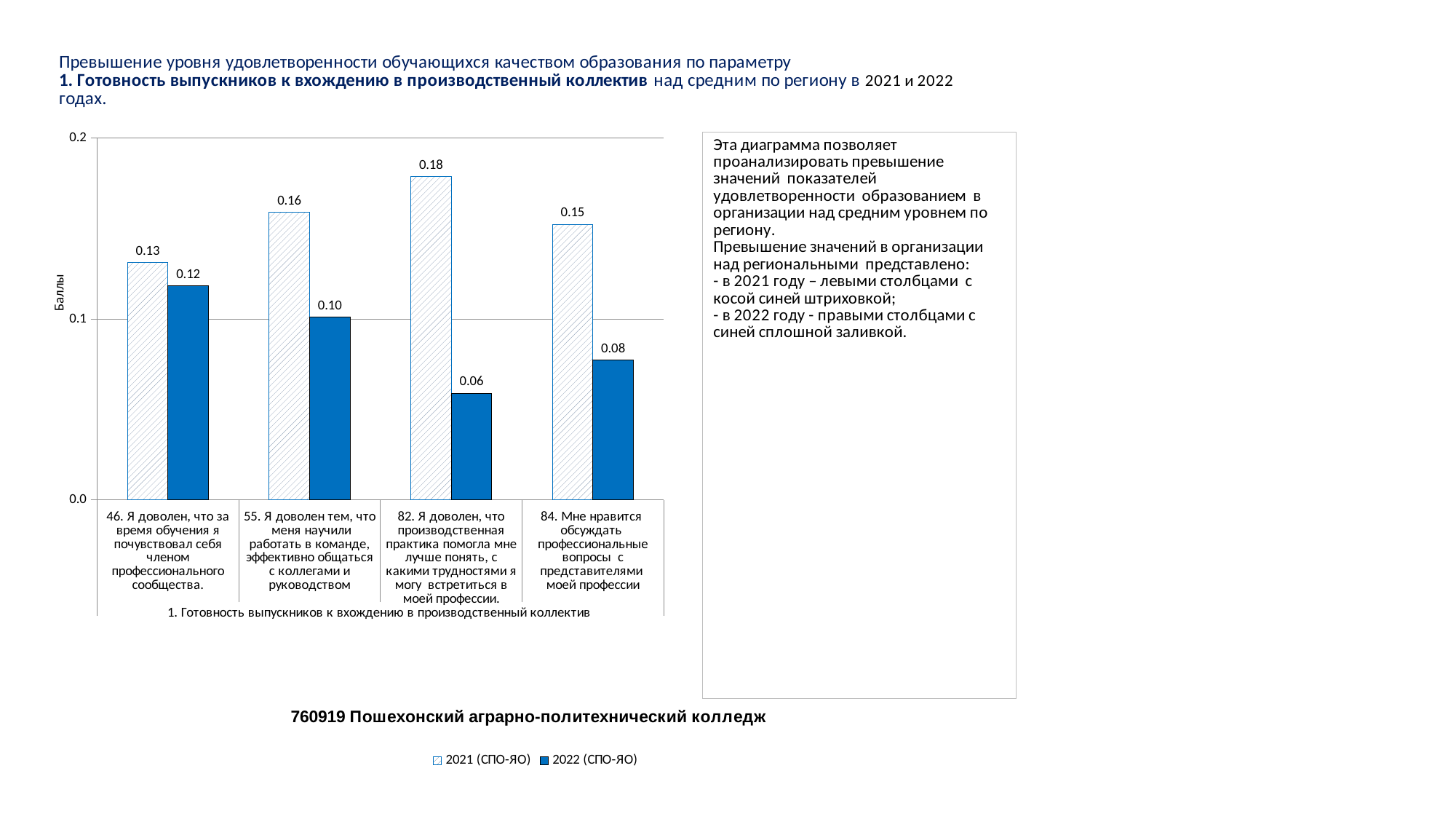
Is the 2022 (СПО-ЯО) value for category 84 greater or less than 0.1? less What is the difference between the 2021 and 2022 values for category 55 (Я доволен тем, что меня научили работать в команде, эффективно общаться с коллегами и руководством)? 0.06 What is the value for 2021 (СПО-ЯО) for category 46 (Я доволен, что за время обучения я почувствовал себя членом профессионального сообщества)? 0.13 What is the value for 2022 (СПО-ЯО) for category 84 (Мне нравится обсуждать профессиональные вопросы с представителями моей профессии)? 0.08 Which is larger for category 46: the 2021 (СПО-ЯО) value or the 2022 (СПО-ЯО) value? 2021 (СПО-ЯО) How many series does the legend list? 2 What is the difference between the 2021 and 2022 values for category 82? 0.12 What kind of chart is shown on the slide? bar chart Which category has the lowest value for 2022 (СПО-ЯО)? 82. Я доволен, что производственная практика помогла мне лучше понять, с какими трудностями я могу встретиться в моей профессии. Which category has the highest value for 2021 (СПО-ЯО)? 82. Я доволен, что производственная практика помогла мне лучше понять, с какими трудностями я могу встретиться в моей профессии. How many categories are shown on the x axis? 4 What is the value for 2022 (СПО-ЯО) for category 82 (Я доволен, что производственная практика помогла мне лучше понять, с какими трудностями я могу встретиться в моей профессии)? 0.06